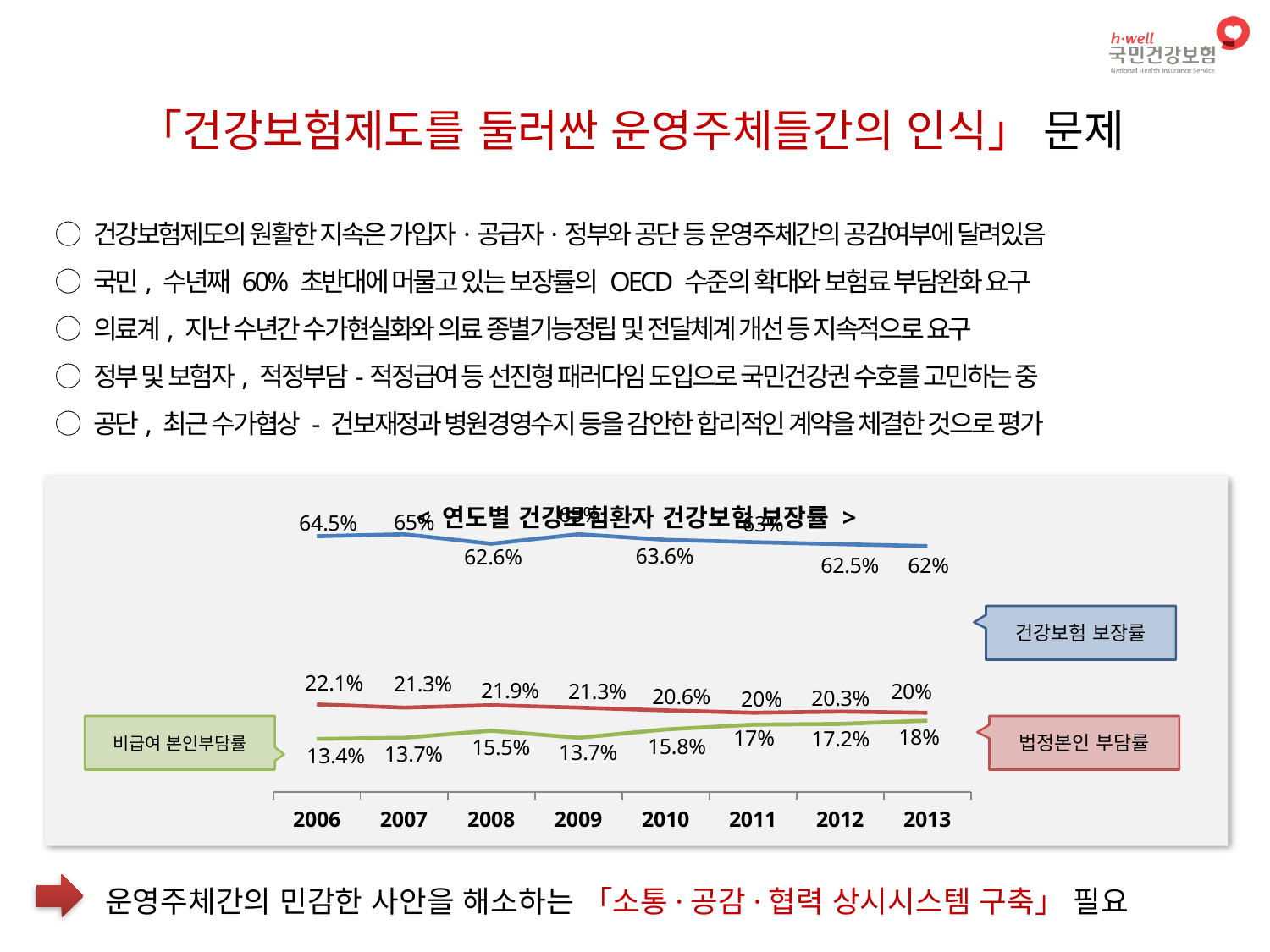
In which year is the 비급여 본인부담률 highest? 2013 How many years are shown on the x axis of the chart? 8 By how much did the 건강보험 보장률 fall from 2006 to 2013? 2.5% In 2010, which is larger: the 법정본인 부담률 or the 비급여 본인부담률? 법정본인 부담률 What is the 법정본인 부담률 value for 2008? 21.9% What is the 건강보험 보장률 value for 2012? 62.5% In which year is the 비급여 본인부담률 lowest? 2006 What kind of chart is shown on the slide? Line chart What is the 건강보험 보장률 value for 2006? 64.5% What is the 비급여 본인부담률 value for 2013? 18% In which year is the 법정본인 부담률 highest? 2006 Does the 비급여 본인부담률 generally rise or fall from 2006 to 2013? Rise